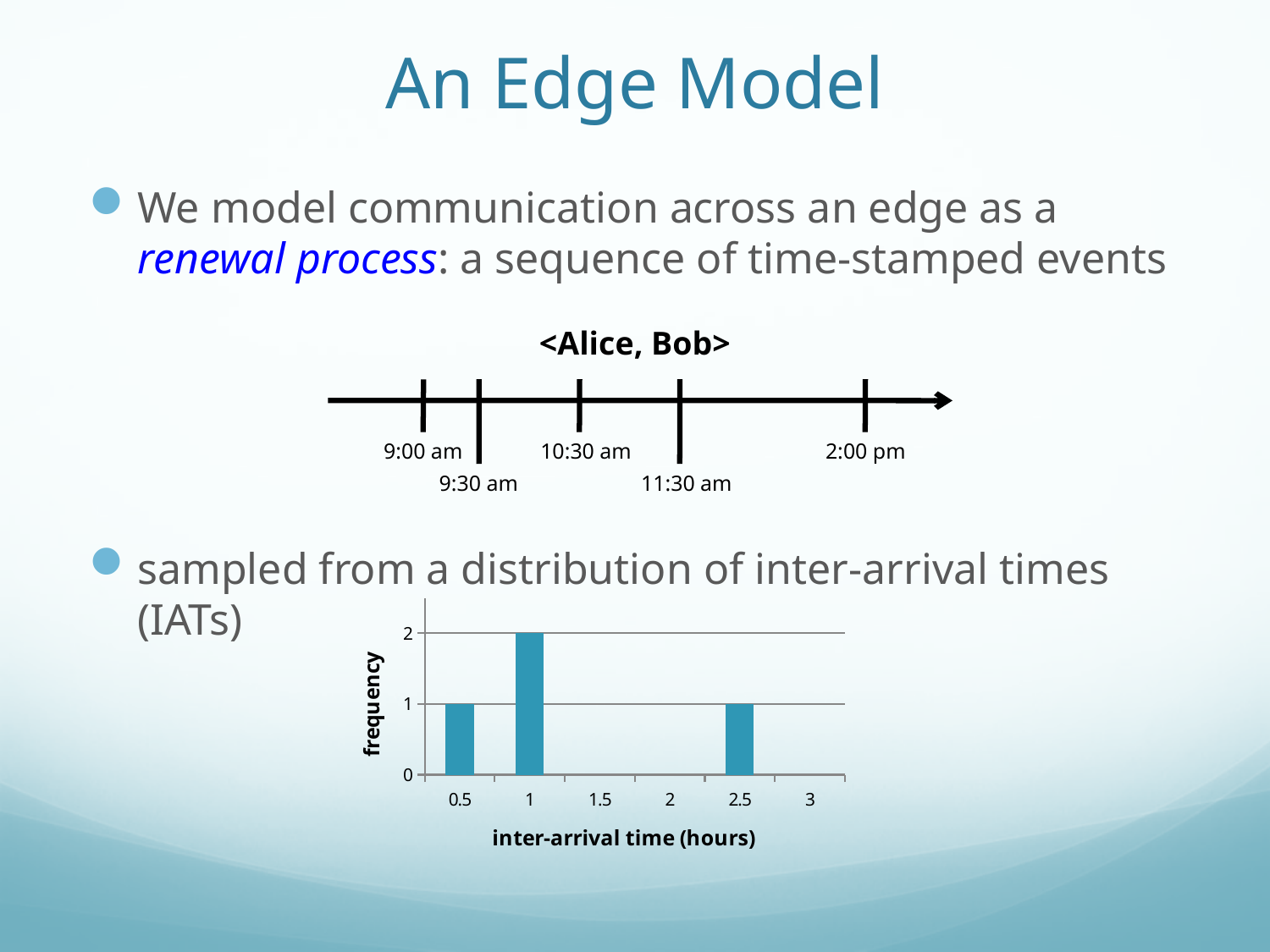
Which has a higher frequency, an inter-arrival time of 1 hour or 0.5 hours? 1 hour What is the frequency for an inter-arrival time of 0.5 hours? 1 How many inter-arrival time categories are labelled on the x axis? 6 What is the label of the x axis of the chart? inter-arrival time (hours) What is the frequency for an inter-arrival time of 2.5 hours? 1 Which inter-arrival time has the highest frequency? 1 What is the frequency for an inter-arrival time of 1.5 hours? 0 What is the label of the y axis of the chart? frequency What kind of chart is shown at the bottom of the slide? bar chart How many inter-arrival time categories have a non-zero frequency? 3 What is the difference in frequency between inter-arrival times of 1 hour and 2.5 hours? 1 What is the frequency for an inter-arrival time of 1 hour? 2